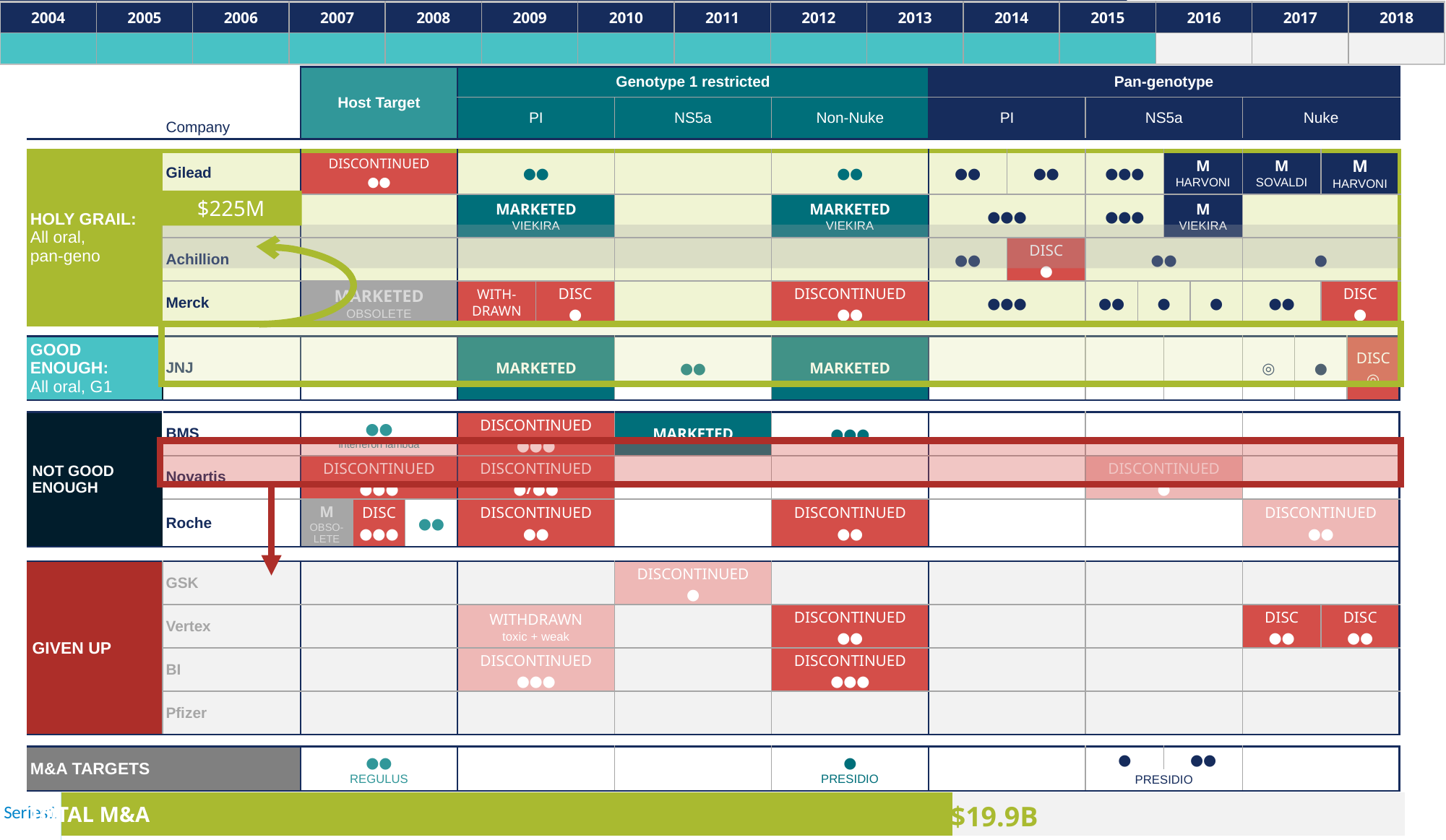
What value is shown for TOTAL M&A in the bar at the bottom of the slide? $19.9B How many years are shown on the timeline across the top of the slide? 15 Through which year is the top timeline bar shaded teal? 2015 What is the first year shown on the timeline across the top of the slide? 2004 What value is printed on the green bar in the HOLY GRAIL section, below Gilead? $225M What kind of chart is the TOTAL M&A element at the bottom of the slide? bar chart What is the name of the series in the legend of the TOTAL M&A bar chart? Series1 What is the last year shown on the timeline across the top of the slide? 2018